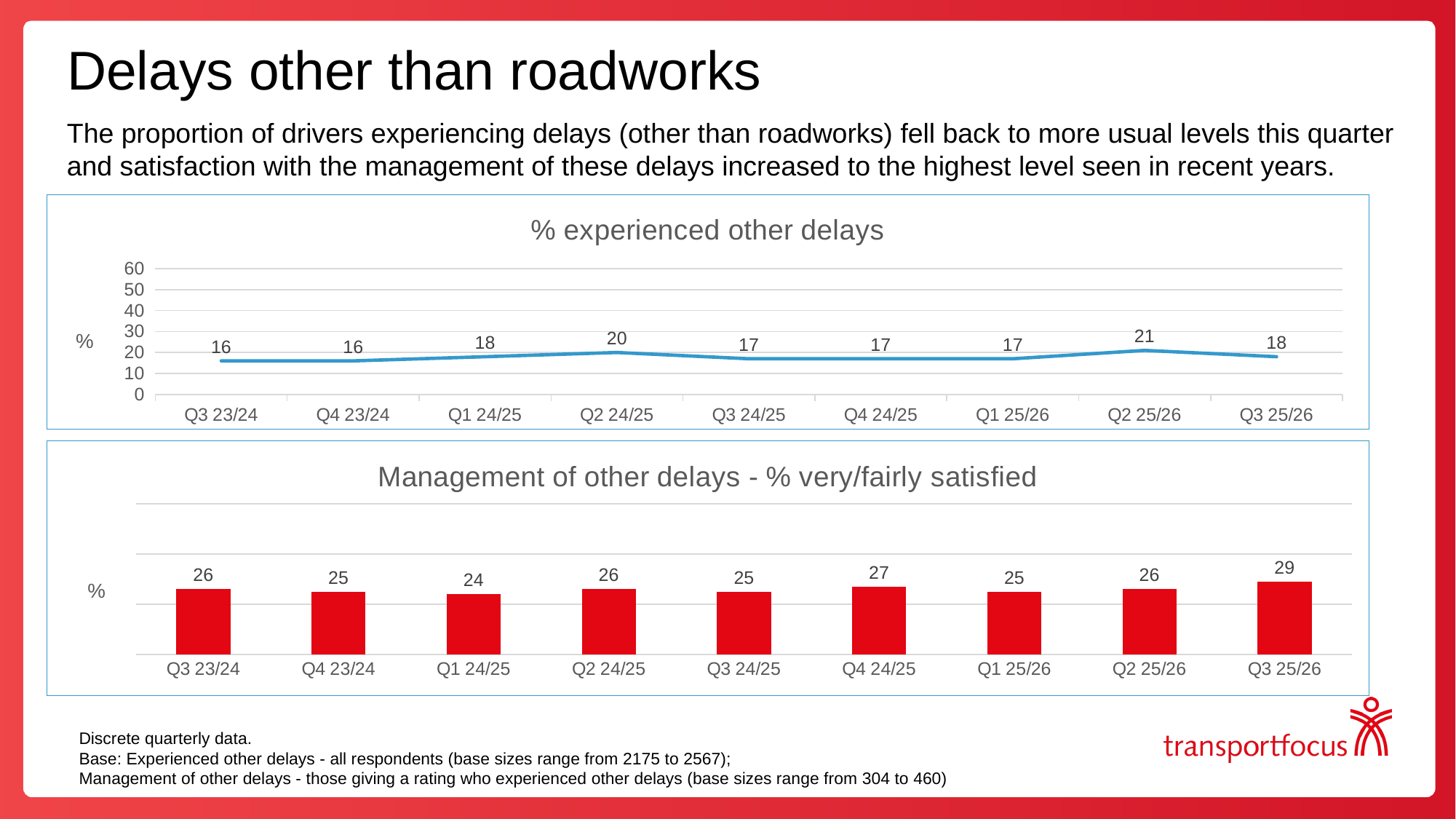
In the '% experienced other delays' chart, how many quarters are plotted? 9 In the 'Management of other delays - % very/fairly satisfied' chart, what is the value for Q3 25/26? 29 In the '% experienced other delays' chart, which quarter has the highest value? Q2 25/26 In the '% experienced other delays' chart, what is the value for Q2 25/26? 21 In the '% experienced other delays' chart, what is the value for Q3 25/26? 18 In the '% experienced other delays' chart, is the value for Q2 24/25 greater or less than 30? less In the '% experienced other delays' chart, what is the difference between Q2 25/26 and Q3 25/26? 3 In the 'Management of other delays - % very/fairly satisfied' chart, which quarter has the highest value? Q3 25/26 In the 'Management of other delays - % very/fairly satisfied' chart, which quarter has the lowest value? Q1 24/25 What kind of chart is '% experienced other delays'? Line chart In the 'Management of other delays - % very/fairly satisfied' chart, which is larger: Q4 24/25 or Q1 25/26? Q4 24/25 What kind of chart is 'Management of other delays - % very/fairly satisfied'? Bar chart